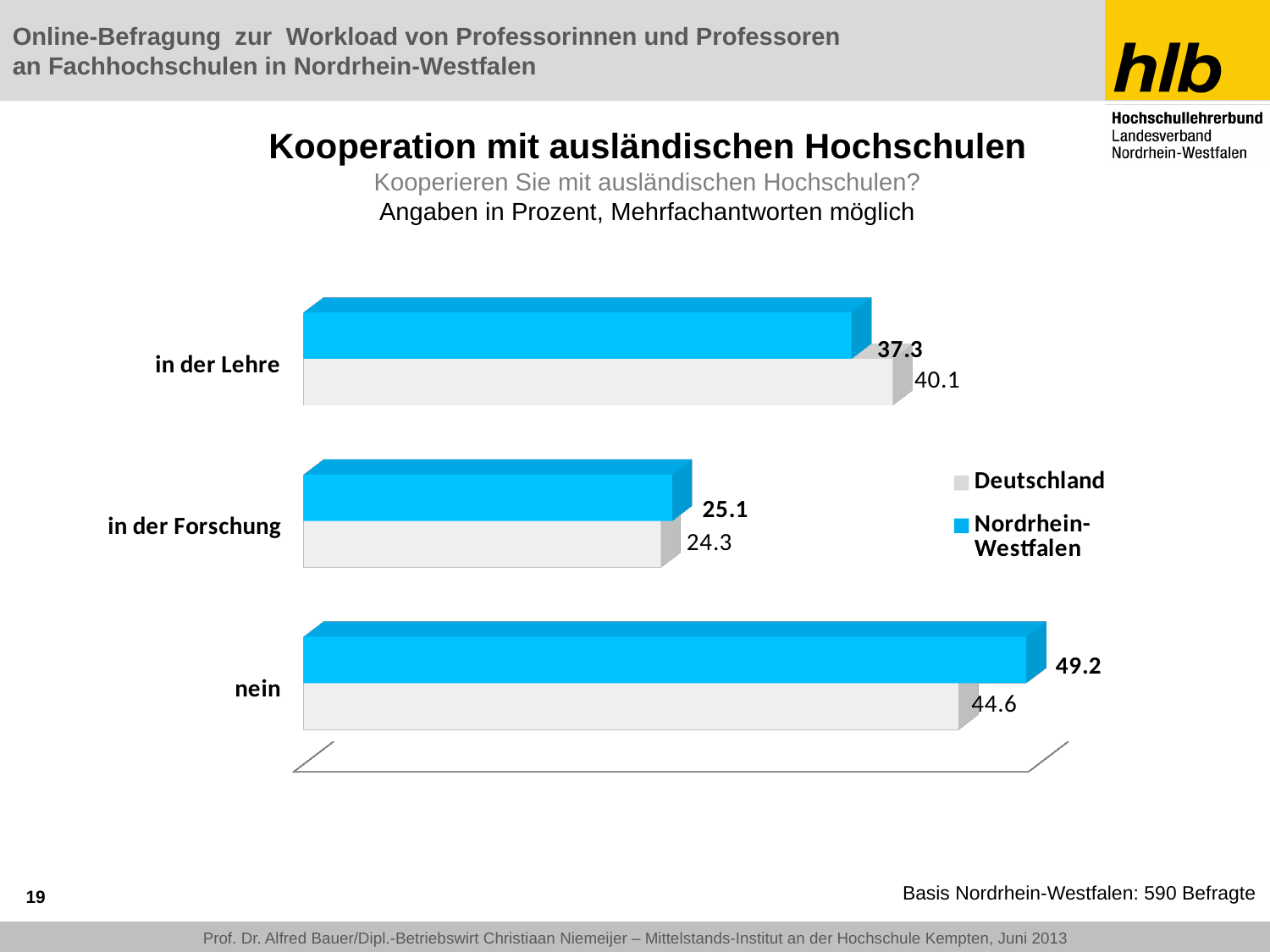
What kind of chart is shown on the slide? Bar chart What is the value for Nordrhein-Westfalen in the category "in der Lehre"? 37.3 What is the value for Nordrhein-Westfalen in the category "in der Forschung"? 25.1 Which colour represents Nordrhein-Westfalen in the chart? Blue What is the value for Deutschland in the category "in der Lehre"? 40.1 How many series does the legend list? 2 In the category "in der Lehre", which series has the larger value, Deutschland or Nordrhein-Westfalen? Deutschland What is the value for Deutschland in the category "nein"? 44.6 Which category has the lowest value for Deutschland? in der Forschung How many categories are shown in the chart? 3 What is the difference between the Nordrhein-Westfalen and Deutschland values in the category "nein"? 4.6 Which category has the highest value for Nordrhein-Westfalen? nein